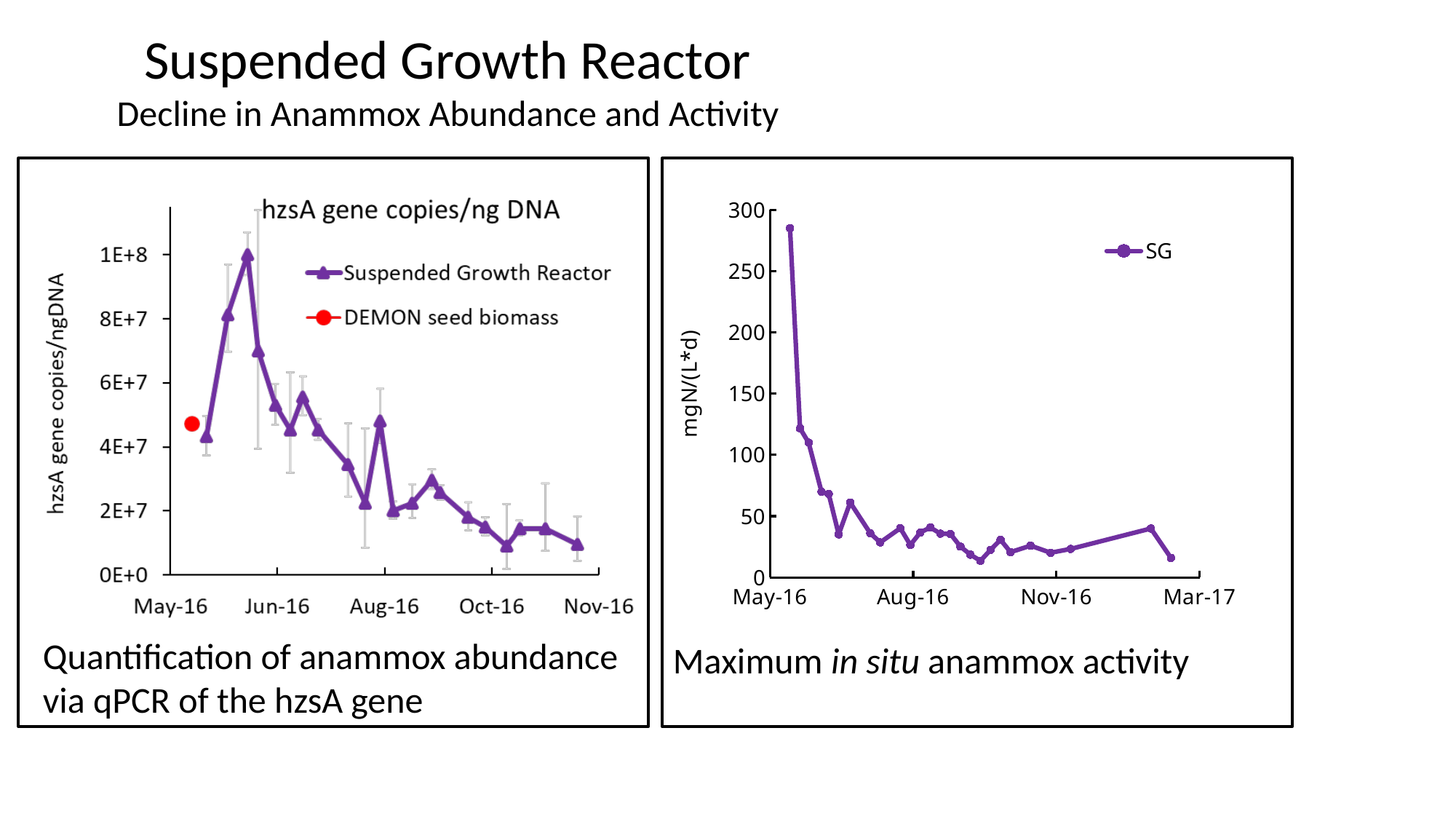
In the right chart (Maximum in situ anammox activity), is the last SG value before Mar-17 greater or less than 50? less In the right chart (Maximum in situ anammox activity), is the first SG value at May-16 greater or less than 250? greater How many series does the legend of the left chart (hzsA gene copies/ng DNA) list? 2 In the left chart (hzsA gene copies/ng DNA), do the Suspended Growth Reactor values rise or fall overall from Jun-16 to Nov-16? fall In the right chart (Maximum in situ anammox activity), do the SG values rise or fall overall from May-16 to Mar-17? fall What kind of chart is the right chart (Maximum in situ anammox activity)? line chart How many series does the legend of the right chart (Maximum in situ anammox activity) list? 1 In the left chart (hzsA gene copies/ng DNA), is the last Suspended Growth Reactor value near Nov-16 greater or less than 2E+7? less What is the y-axis label of the right chart (Maximum in situ anammox activity)? mgN/(L*d) What kind of chart is the left chart titled "hzsA gene copies/ng DNA"? line chart